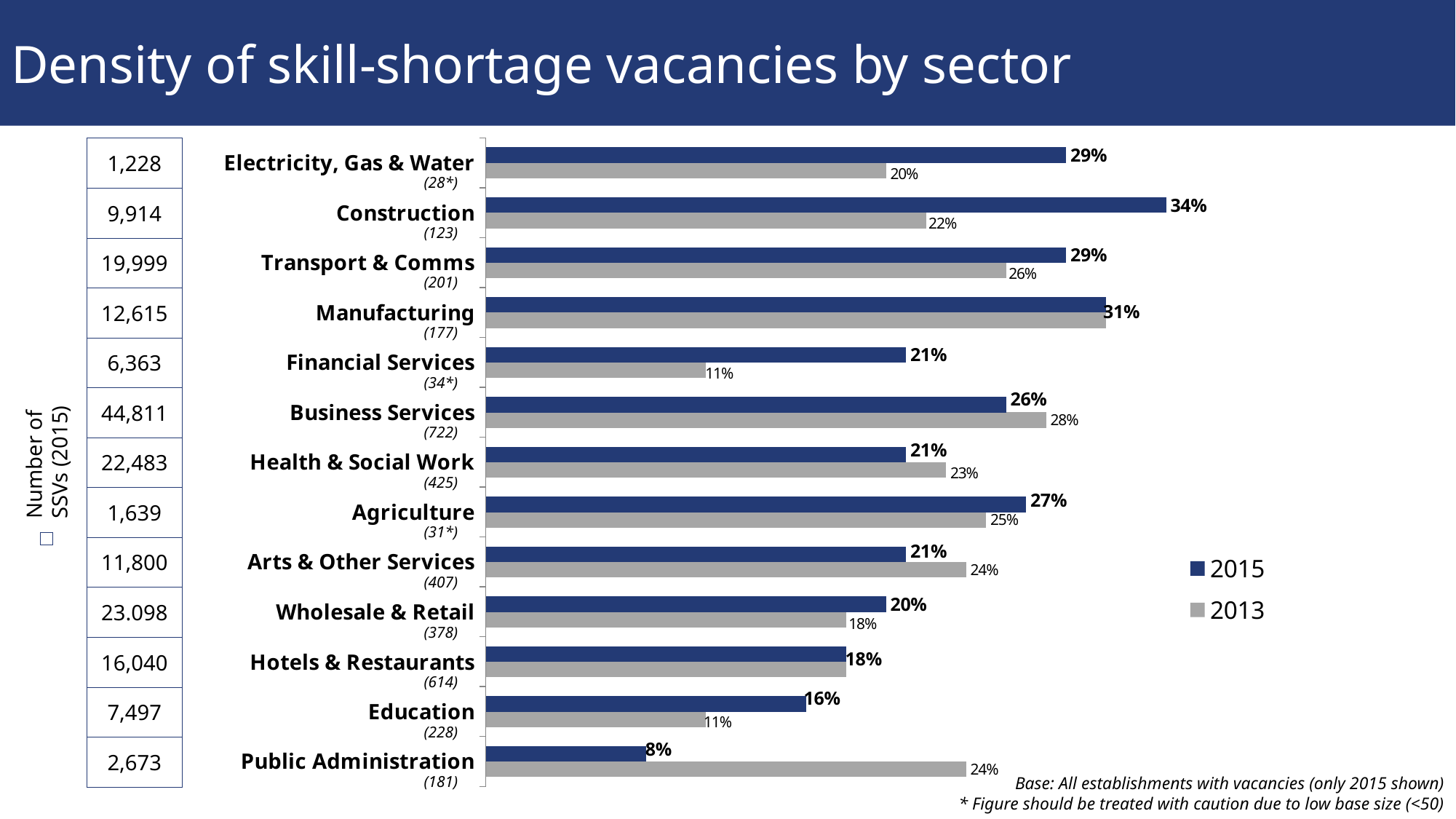
What is the 2013 value for Financial Services? 11% What type of chart is shown on the slide? Bar chart What is the 2015 skill-shortage vacancy density for Construction? 34% What is the difference between the 2015 and 2013 values for Electricity, Gas & Water? 9 percentage points Which sector has the highest skill-shortage vacancy density in 2015? Construction For Business Services, which year has the higher density, 2015 or 2013? 2013 How many sectors are shown in the chart? 13 Which sector has the lowest skill-shortage vacancy density in 2015? Public Administration By how many percentage points did Public Administration's density fall from 2013 to 2015? 16 percentage points How many series does the legend list? 2 What are the two entries in the chart legend? 2015 and 2013 What is the 2015 value for Education? 16%